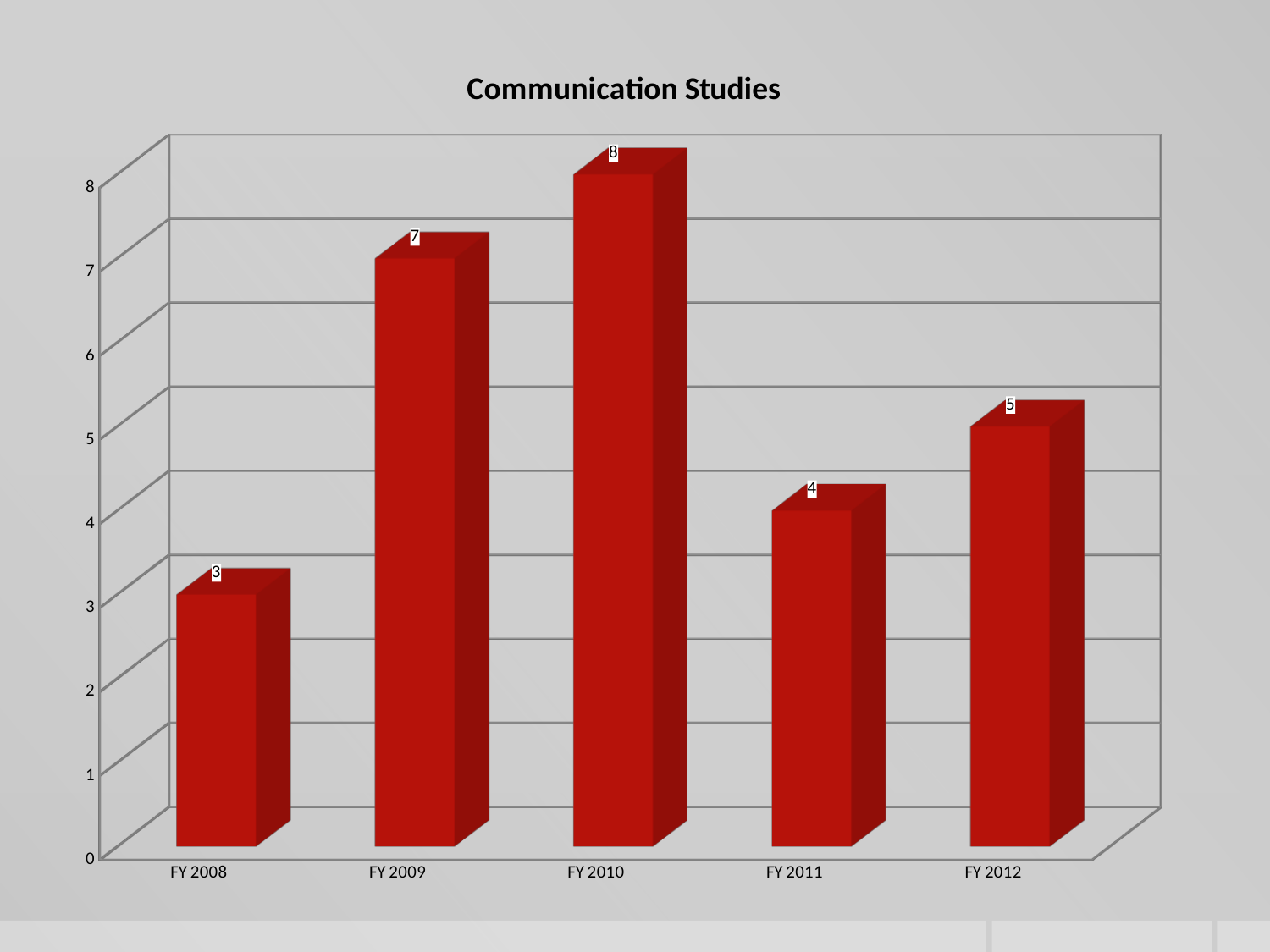
What is the value for FY 2012? 5 Which fiscal year has the lowest value? FY 2008 What is the difference between the values for FY 2010 and FY 2011? 4 What kind of chart is shown on the slide? bar chart What is the value for FY 2010? 8 Which fiscal year has the highest value? FY 2010 What is the difference between the values for FY 2009 and FY 2008? 4 What is the value for FY 2008? 3 How many fiscal years are shown on the chart? 5 What is the title of the chart? Communication Studies Is the value for FY 2009 greater or less than 6? greater Which is larger, the value for FY 2011 or the value for FY 2012? FY 2012